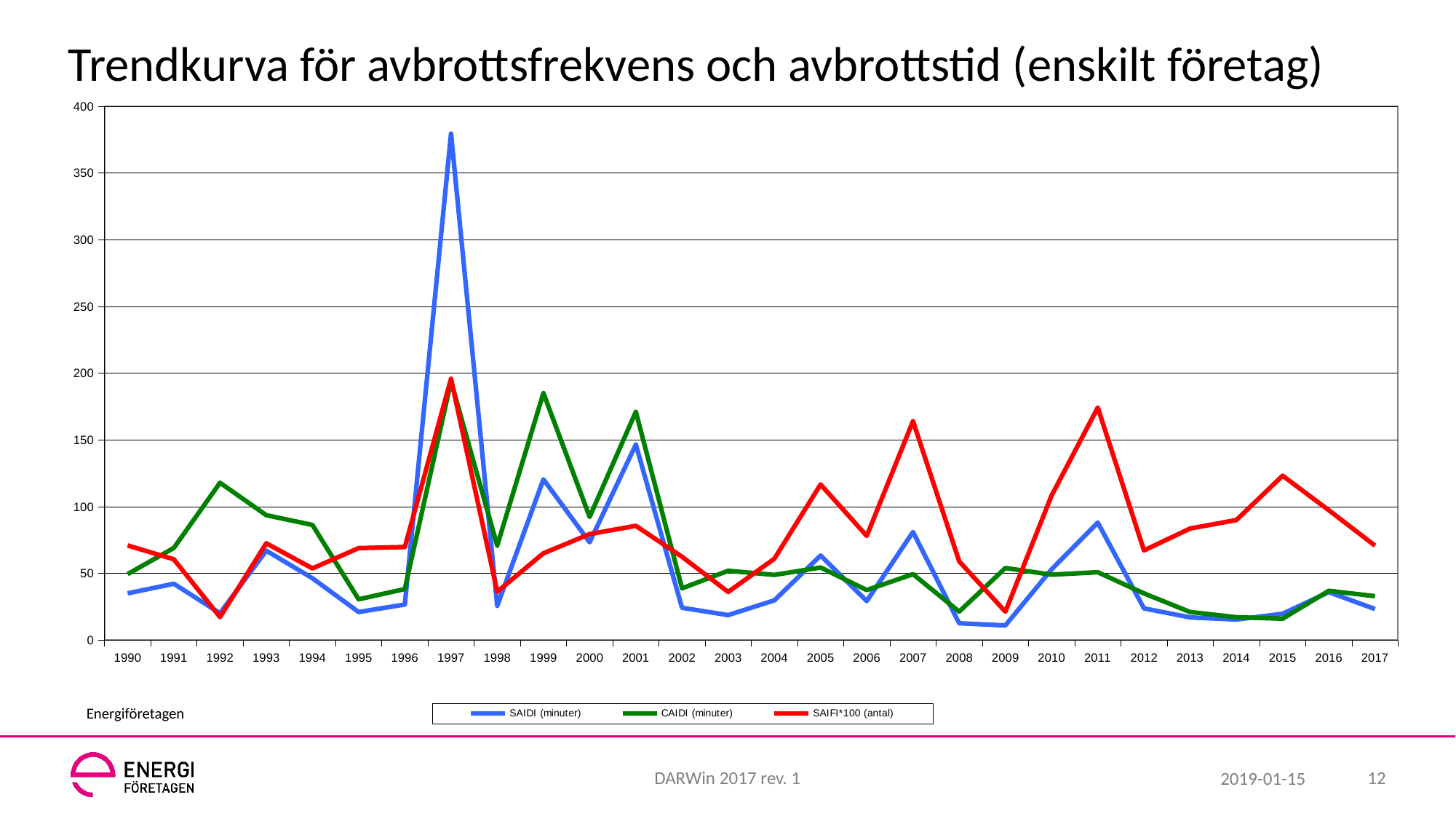
What colour is the line for SAIFI*100 (antal)? red In which year does the SAIDI (minuter) series reach its highest value? 1997 In 1999, which series has the higher value: CAIDI (minuter) or SAIDI (minuter)? CAIDI (minuter) How many years are plotted along the x axis? 28 Is the value for SAIDI (minuter) in 2009 greater or less than 50? less How many series does the legend list? 3 In 2007, which series has the higher value: SAIFI*100 (antal) or SAIDI (minuter)? SAIFI*100 (antal) In which year does the SAIFI*100 (antal) series reach its highest value? 1997 Is the value for SAIFI*100 (antal) in 2011 greater or less than 150? greater Is the value for SAIDI (minuter) in 1997 greater or less than 350? greater In which year does the CAIDI (minuter) series reach its highest value? 1997 What kind of chart is shown on the slide? line chart